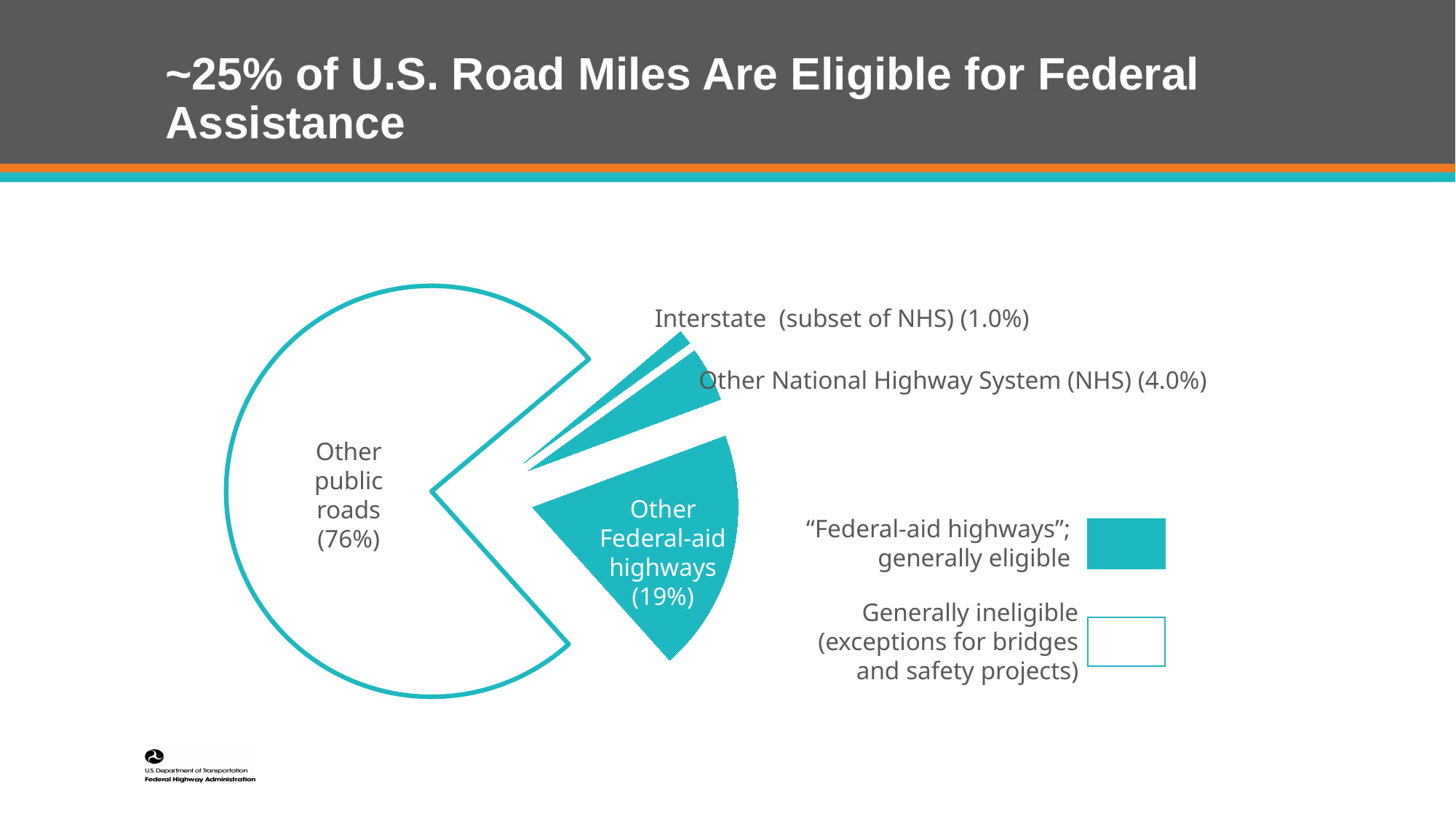
What kind of chart is shown on the slide? Pie chart What share of U.S. road miles is labelled as Other public roads? 76% What share of U.S. road miles is labelled as Other National Highway System (NHS)? 4.0% What share of U.S. road miles is labelled as Other Federal-aid highways? 19% Which slice of the pie chart is the largest? Other public roads According to the legend, what do the solid teal slices represent? "Federal-aid highways"; generally eligible What is the difference in percentage points between Other public roads and Other Federal-aid highways? 57 What is the combined share of the three Federal-aid highway slices (Interstate, Other NHS, Other Federal-aid highways)? 24.0% Which is larger: the Other National Highway System (NHS) slice or the Interstate (subset of NHS) slice? Other National Highway System (NHS) How many slices does the pie chart have? 4 What share of U.S. road miles is labelled as Interstate (subset of NHS)? 1.0% Which slice of the pie chart is the smallest? Interstate (subset of NHS)